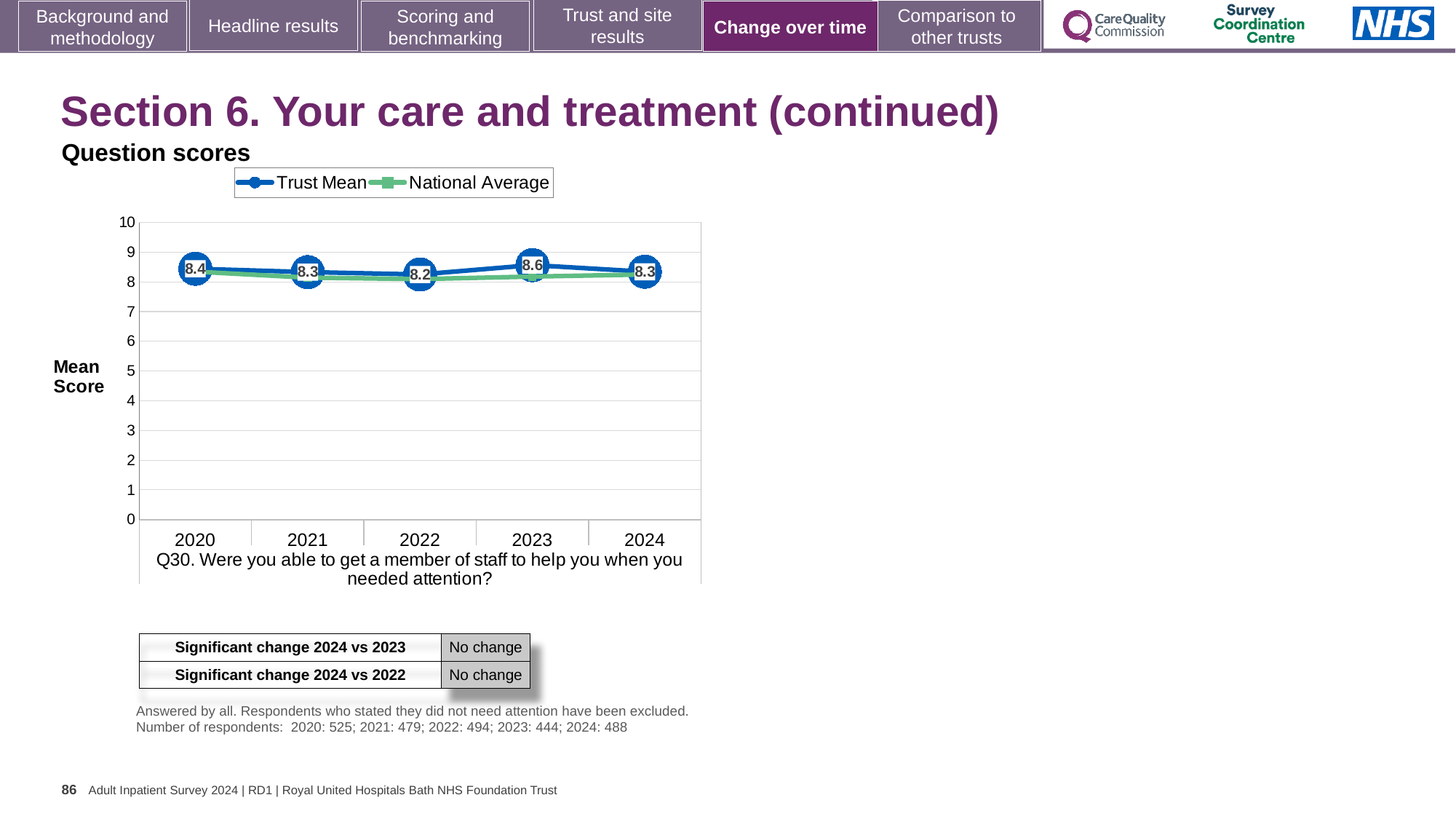
What is the Trust Mean score for 2022? 8.2 What kind of chart is shown? line chart In which year is the Trust Mean lowest? 2022 How many series does the legend list? 2 In which year is the Trust Mean highest? 2023 What is the Trust Mean score for 2020? 8.4 Which is larger, the Trust Mean in 2020 or in 2021? 2020 Is the Trust Mean for 2024 greater or less than 7? greater How many years are plotted on the x axis? 5 What is the label of the y axis? Mean Score What is the difference between the Trust Mean in 2023 and in 2022? 0.4 What is the Trust Mean score for 2023? 8.6